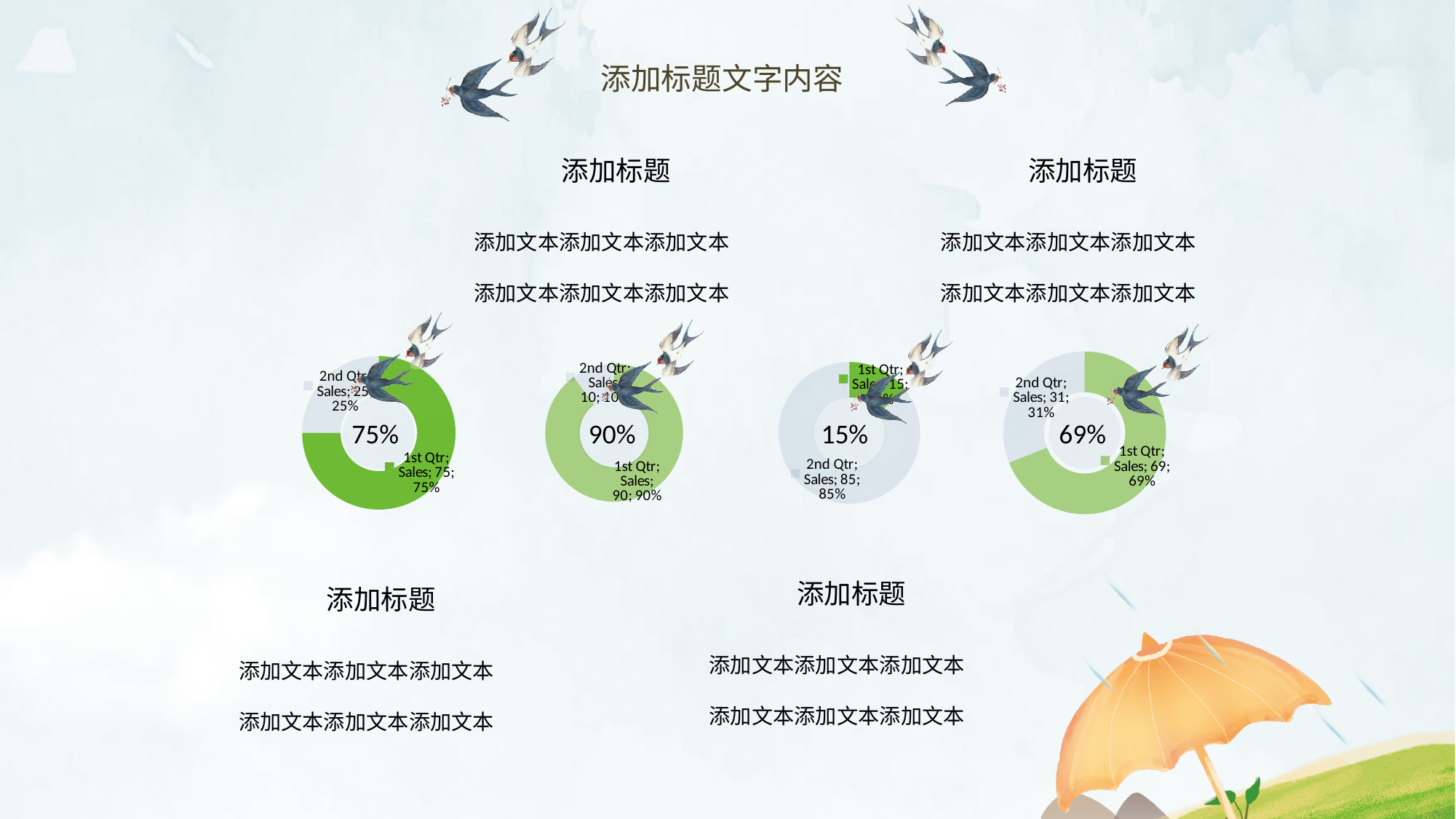
What kind of chart is the leftmost chart on the slide? doughnut chart In the leftmost chart, what is the Sales value for 1st Qtr? 75 In the second chart from the left, what is the difference between the 1st Qtr and 2nd Qtr Sales values? 80 How many categories does the rightmost chart show? 2 In the second chart from the left, what is the Sales value for 2nd Qtr? 10 In the rightmost chart, what is the Sales value for 1st Qtr? 69 In the second chart from the left, which category has the largest share? 1st Qtr In the rightmost chart, which is larger, the 1st Qtr value or the 2nd Qtr value? 1st Qtr In the third chart from the left, which category has the smallest share? 1st Qtr What percentage is printed in the centre of the third chart from the left? 15% In the third chart from the left, what is the Sales value for 2nd Qtr? 85 In the leftmost chart, what percentage share does 2nd Qtr have? 25%